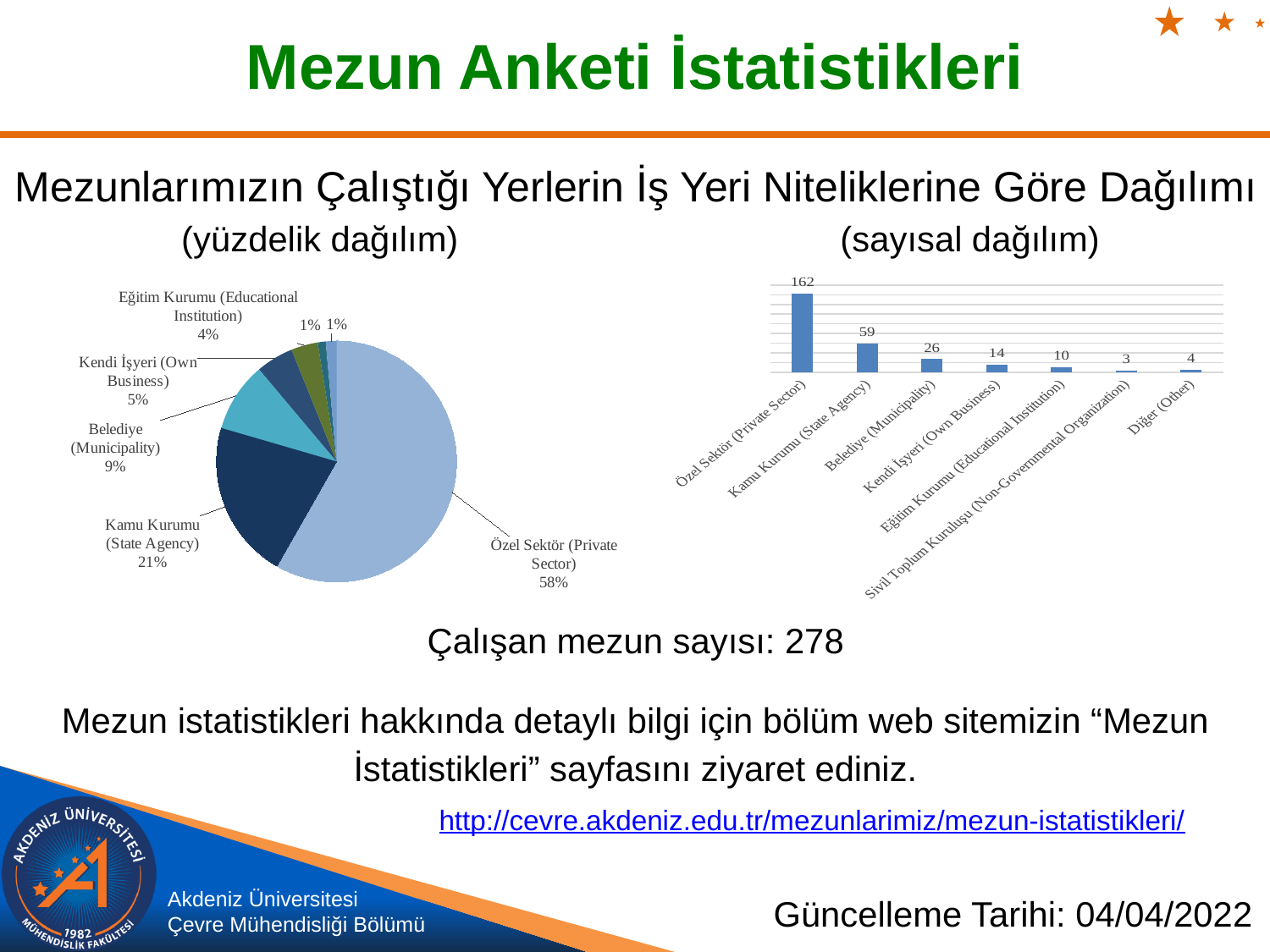
In the bar chart on the right (sayısal dağılım), what is the difference between Özel Sektör (Private Sector) and Kamu Kurumu (State Agency)? 103 In the bar chart on the right (sayısal dağılım), what is the value for Belediye (Municipality)? 26 In the bar chart on the right (sayısal dağılım), which category has the lowest value? Sivil Toplum Kuruluşu (Non-Governmental Organization) In the pie chart on the left (yüzdelik dağılım), what share does Özel Sektör (Private Sector) have? 58% What kind of chart is the chart on the right (sayısal dağılım)? Bar chart In the bar chart on the right (sayısal dağılım), what is the value for Özel Sektör (Private Sector)? 162 In the pie chart on the left (yüzdelik dağılım), what share does Kamu Kurumu (State Agency) have? 21% What kind of chart is the chart on the left (yüzdelik dağılım)? Pie chart In the pie chart on the left (yüzdelik dağılım), what is the difference between the shares of Belediye (Municipality) and Kendi İşyeri (Own Business)? 4% In the bar chart on the right (sayısal dağılım), which is larger: Kendi İşyeri (Own Business) or Eğitim Kurumu (Educational Institution)? Kendi İşyeri (Own Business) In the bar chart on the right (sayısal dağılım), how many categories are shown? 7 In the bar chart on the right (sayısal dağılım), which category has the highest value? Özel Sektör (Private Sector)